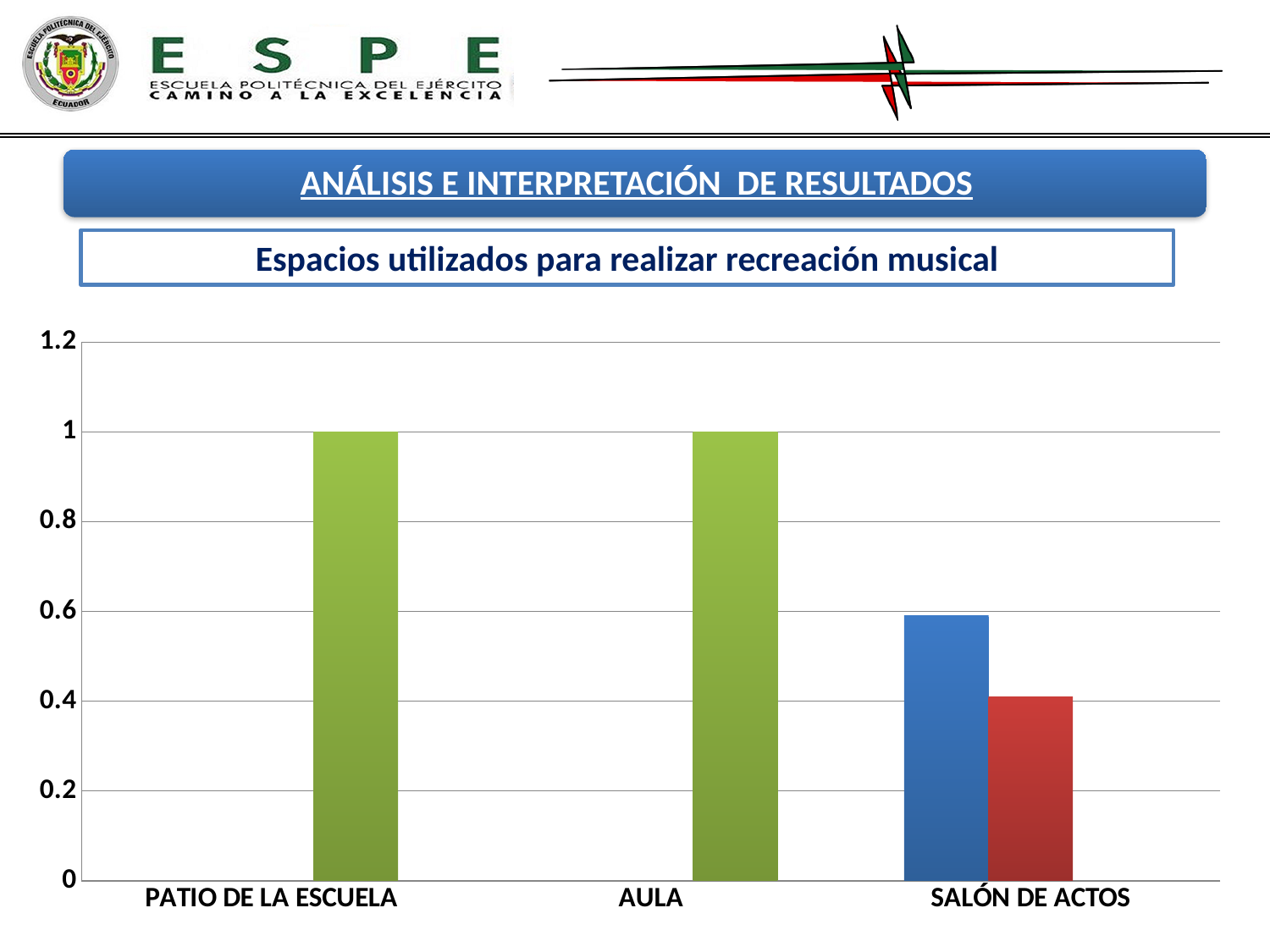
What is the title of the chart? Espacios utilizados para realizar recreación musical What kind of chart is shown on the slide? bar chart What is the value of the bar for AULA? 1 Is the value of the blue bar for SALÓN DE ACTOS greater or less than 0.4? greater Which category contains the lowest bar in the chart? SALÓN DE ACTOS For SALÓN DE ACTOS, which bar is taller, the blue one or the red one? the blue one What colour are the bars for PATIO DE LA ESCUELA and AULA? green Is the value of the red bar for SALÓN DE ACTOS greater or less than 0.2? greater Is the value of the red bar for SALÓN DE ACTOS greater or less than 0.6? less What is the value of the bar for PATIO DE LA ESCUELA? 1 How many categories are shown on the x axis of the chart? 3